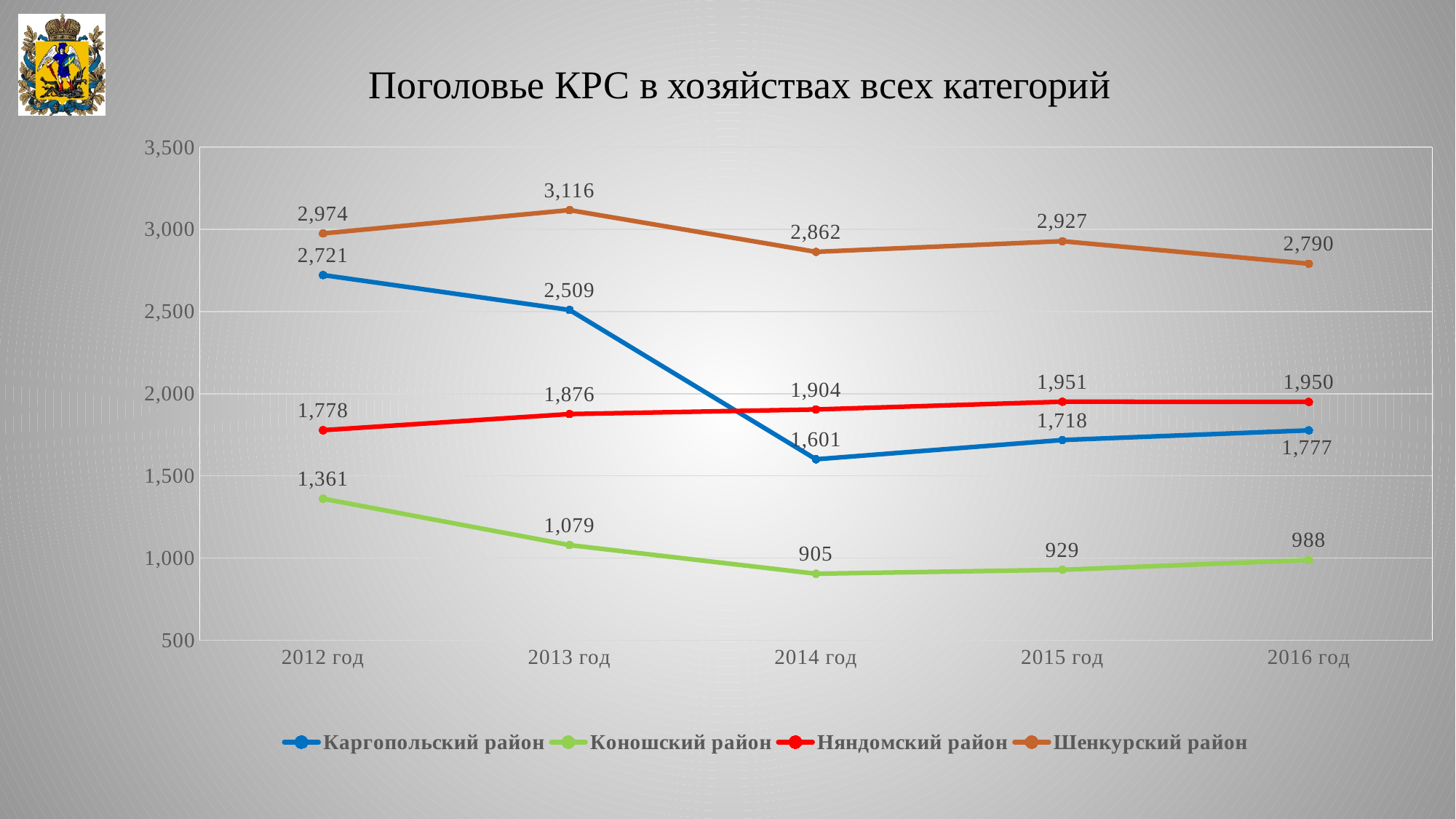
How many series does the legend list? 4 Does the value for Няндомский район rise or fall from 2012 год to 2015 год? rise What is the title of the chart? Поголовье КРС в хозяйствах всех категорий What type of chart is shown on the slide? line chart In which year does Шенкурский район reach its highest value? 2013 год Which is larger in 2016 год: Няндомский район or Каргопольский район? Няндомский район What is the difference between the values for Каргопольский район in 2013 год and 2014 год? 908 In which year does Коношский район have its lowest value? 2014 год How many years are shown on the x axis? 5 What is the value for Коношский район in 2016 год? 988 What is the value for Шенкурский район in 2013 год? 3,116 What is the value for Каргопольский район in 2014 год? 1,601